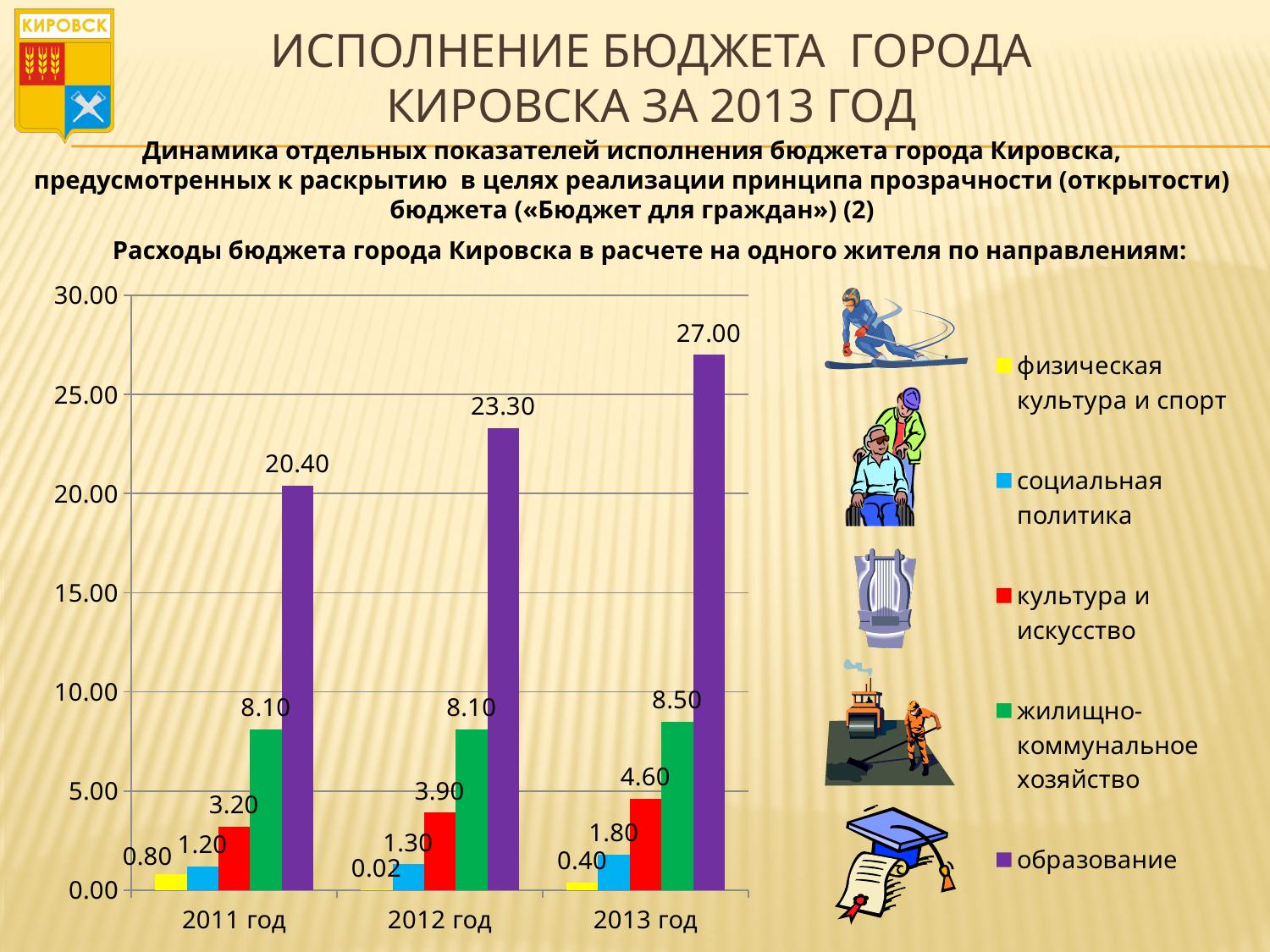
What is the difference between the образование values for 2013 год and 2011 год? 6.60 What is the value for физическая культура и спорт in 2012 год? 0.02 In which year is the value for образование the highest? 2013 год What is the value for жилищно-коммунальное хозяйство in 2011 год? 8.10 What kind of chart is shown on the slide? bar chart Which is larger: социальная политика in 2013 год or культура и искусство in 2011 год? культура и искусство in 2011 год Do the values for образование rise or fall from 2011 год to 2013 год? rise How many years are shown on the x axis? 3 What is the value for культура и искусство in 2013 год? 4.60 How many series does the legend list? 5 What is the value for образование in 2013 год? 27.00 In which year is the value for физическая культура и спорт the lowest? 2012 год